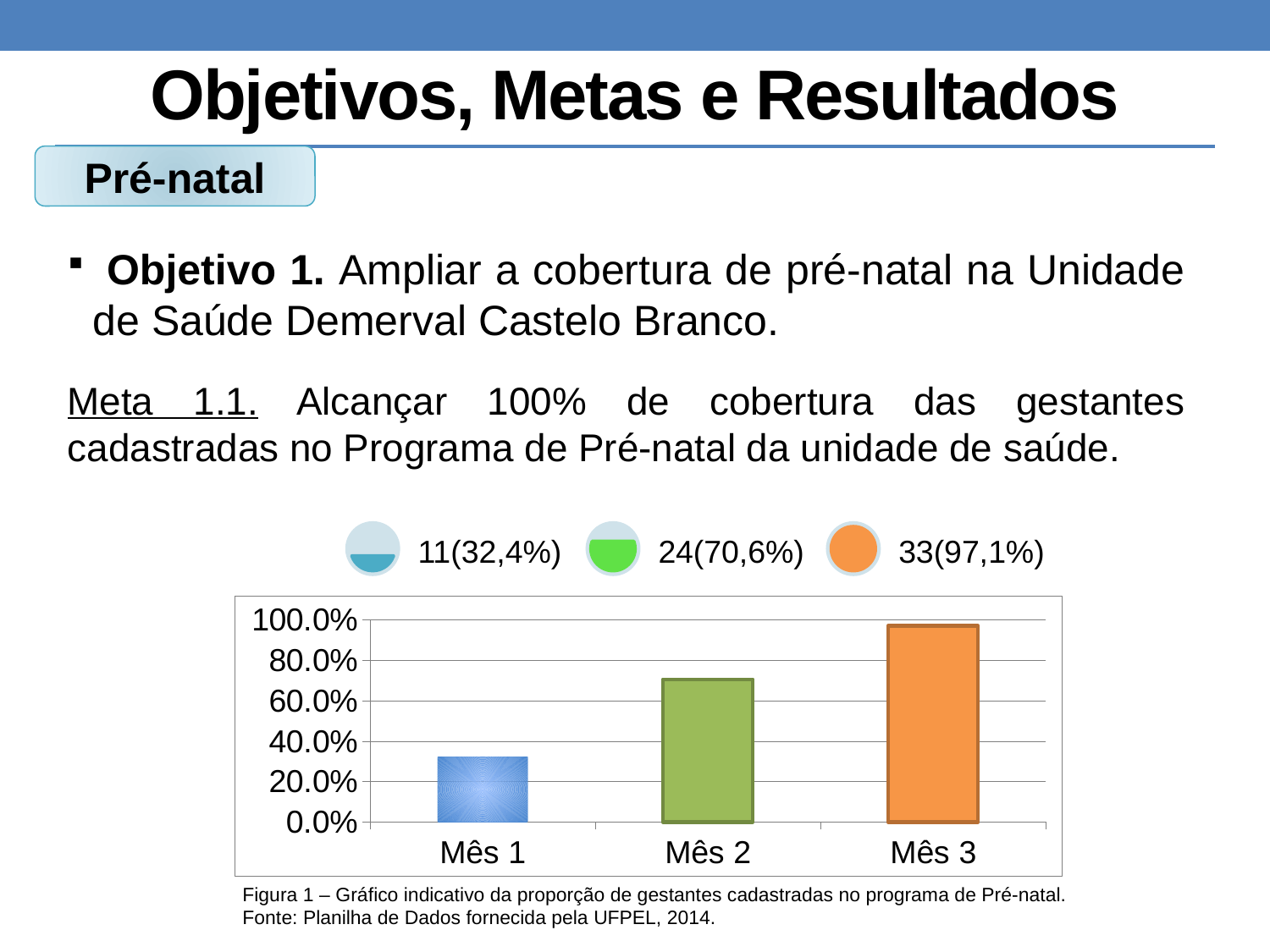
How many bars (months) are plotted in the chart? 3 What is the highest value shown on the y axis of the chart? 100.0% Do the values rise or fall from Mês 1 to Mês 3? rise According to the labels above the chart, what percentage corresponds to the orange bar (Mês 3)? 97,1% Is the value for Mês 3 greater or less than 80.0%? greater According to the labels above the chart, what percentage corresponds to the blue bar (Mês 1)? 32,4% Which month has the lowest bar in the chart? Mês 1 Is the value for Mês 2 greater or less than 60.0%? greater Is the value for Mês 1 greater or less than 40.0%? less Which month has the highest bar in the chart? Mês 3 What kind of chart is shown on the slide? bar chart Which is larger, the value for Mês 2 or the value for Mês 3? Mês 3